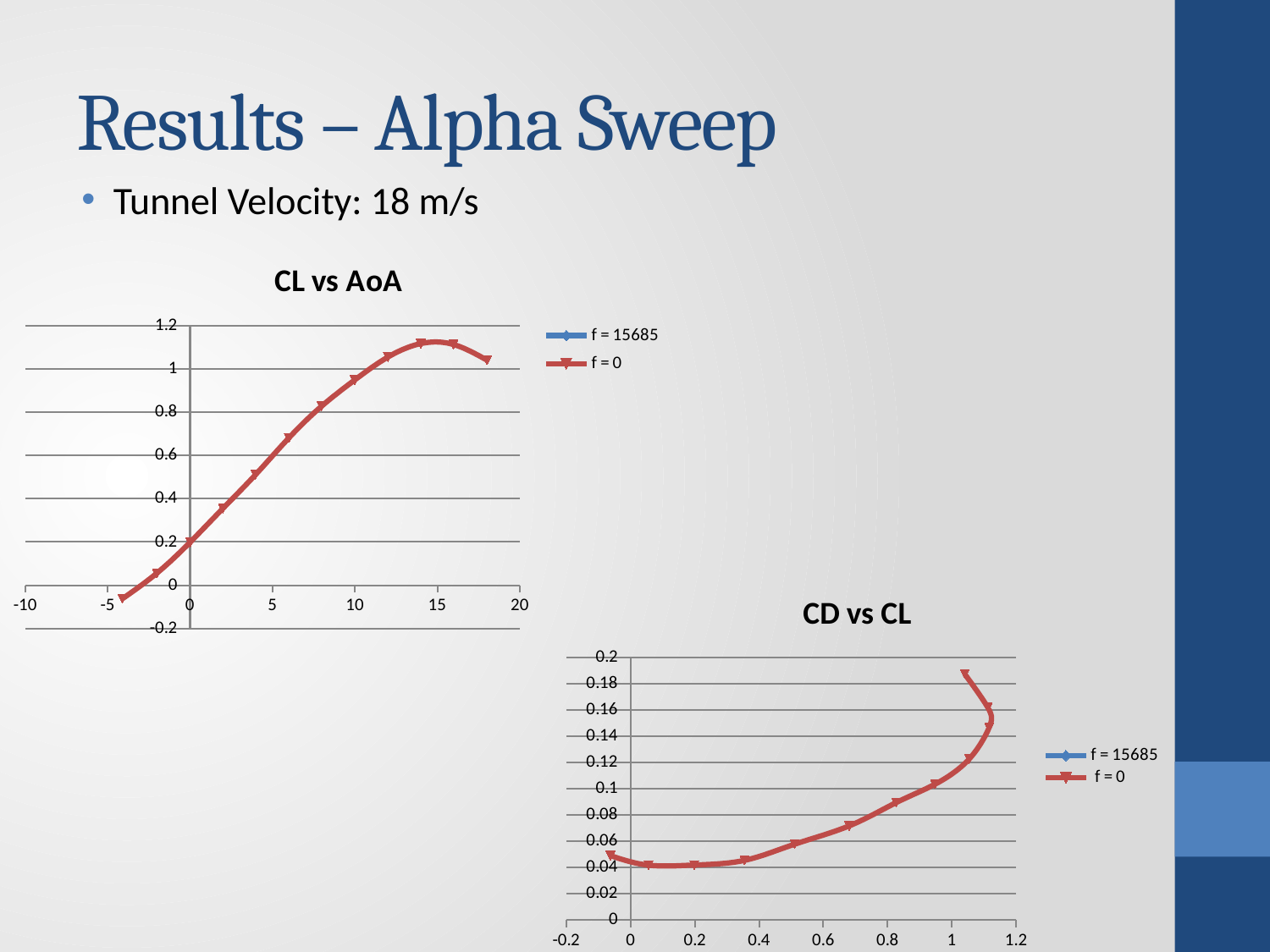
In the "CL vs AoA" chart, does CL rise or fall as AoA increases from 0 to 10? rise In the "CL vs AoA" chart, is the CL value at AoA 10 greater or less than 0.8? greater In the "CD vs CL" chart, is the CD value at CL 0.5 greater or less than 0.08? less How many series does the legend of the "CD vs CL" chart list? 2 What kind of chart is the "CL vs AoA" chart? line chart In the "CL vs AoA" chart, which series is drawn in red with triangle markers? f = 0 In the "CL vs AoA" chart, does CL rise or fall as AoA increases from 15 to 18? fall What kind of chart is the "CD vs CL" chart? line chart How many series does the legend of the "CL vs AoA" chart list? 2 What are the two legend entries on the "CD vs CL" chart? f = 15685 and f = 0 In the "CL vs AoA" chart, is the CL value at AoA 14 greater or less than 1? greater